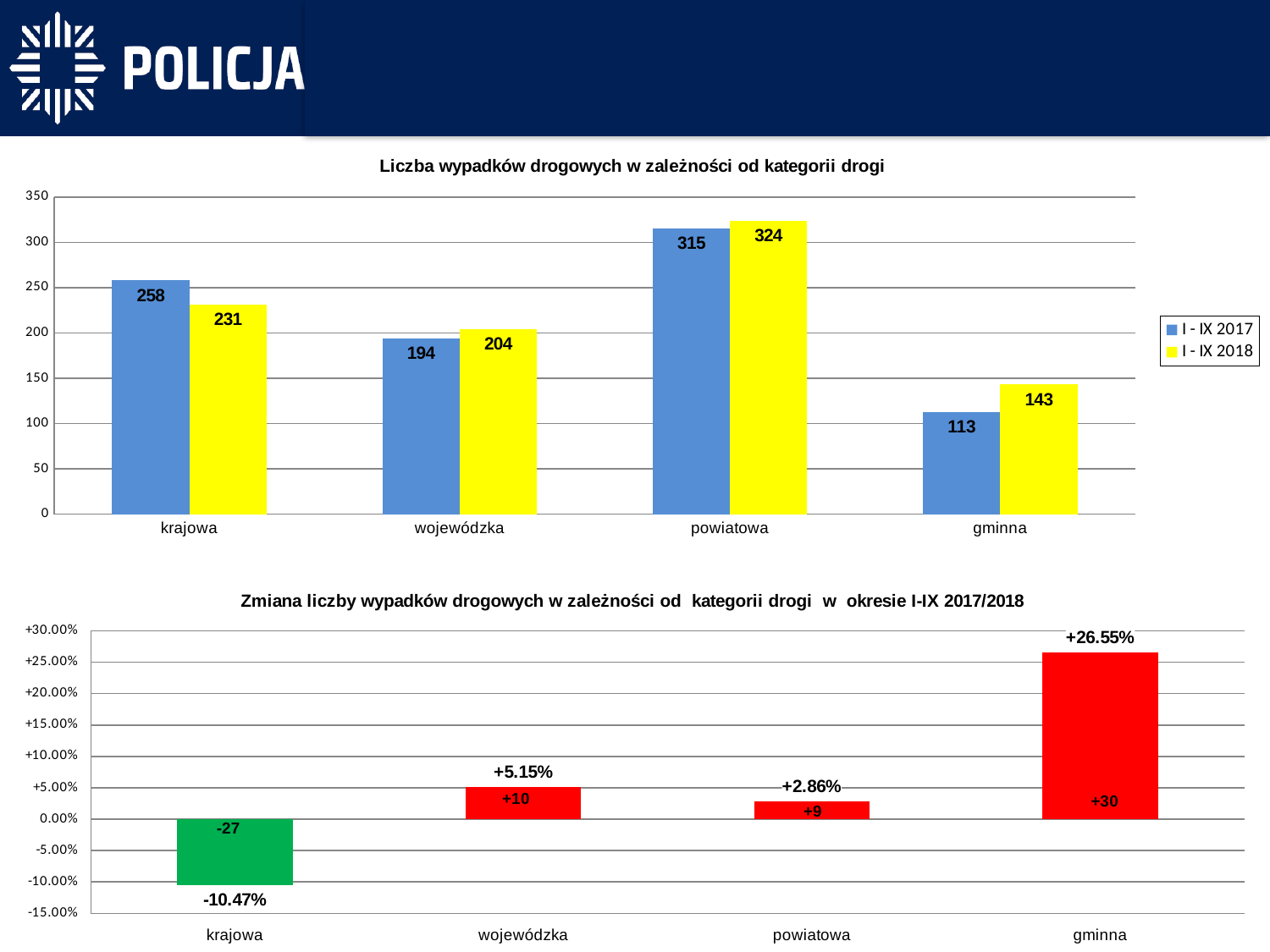
How many series does the legend of the chart 'Liczba wypadków drogowych w zależności od kategorii drogi' list? 2 How many road categories are shown in the chart 'Liczba wypadków drogowych w zależności od kategorii drogi'? 4 In the chart 'Liczba wypadków drogowych w zależności od kategorii drogi', which is larger for wojewódzka: the I - IX 2017 value or the I - IX 2018 value? I - IX 2018 In the chart 'Liczba wypadków drogowych w zależności od kategorii drogi', what is the value for powiatowa in I - IX 2018? 324 What kind of chart is the bottom chart 'Zmiana liczby wypadków drogowych...'? bar chart In the chart 'Liczba wypadków drogowych w zależności od kategorii drogi', what is the difference between the I - IX 2017 and I - IX 2018 values for krajowa? 27 In the bottom chart 'Zmiana liczby wypadków drogowych...', what is the percentage change for gminna? +26.55% In the chart 'Liczba wypadków drogowych w zależności od kategorii drogi', which road category has the lowest value in I - IX 2017? gminna In the bottom chart 'Zmiana liczby wypadków drogowych...', what colour is the bar for krajowa? green In the chart 'Liczba wypadków drogowych w zależności od kategorii drogi', what is the value for gminna in I - IX 2017? 113 In the bottom chart 'Zmiana liczby wypadków drogowych...', which road category has the lowest percentage change? krajowa In the chart 'Liczba wypadków drogowych w zależności od kategorii drogi', which road category has the highest value in I - IX 2018? powiatowa